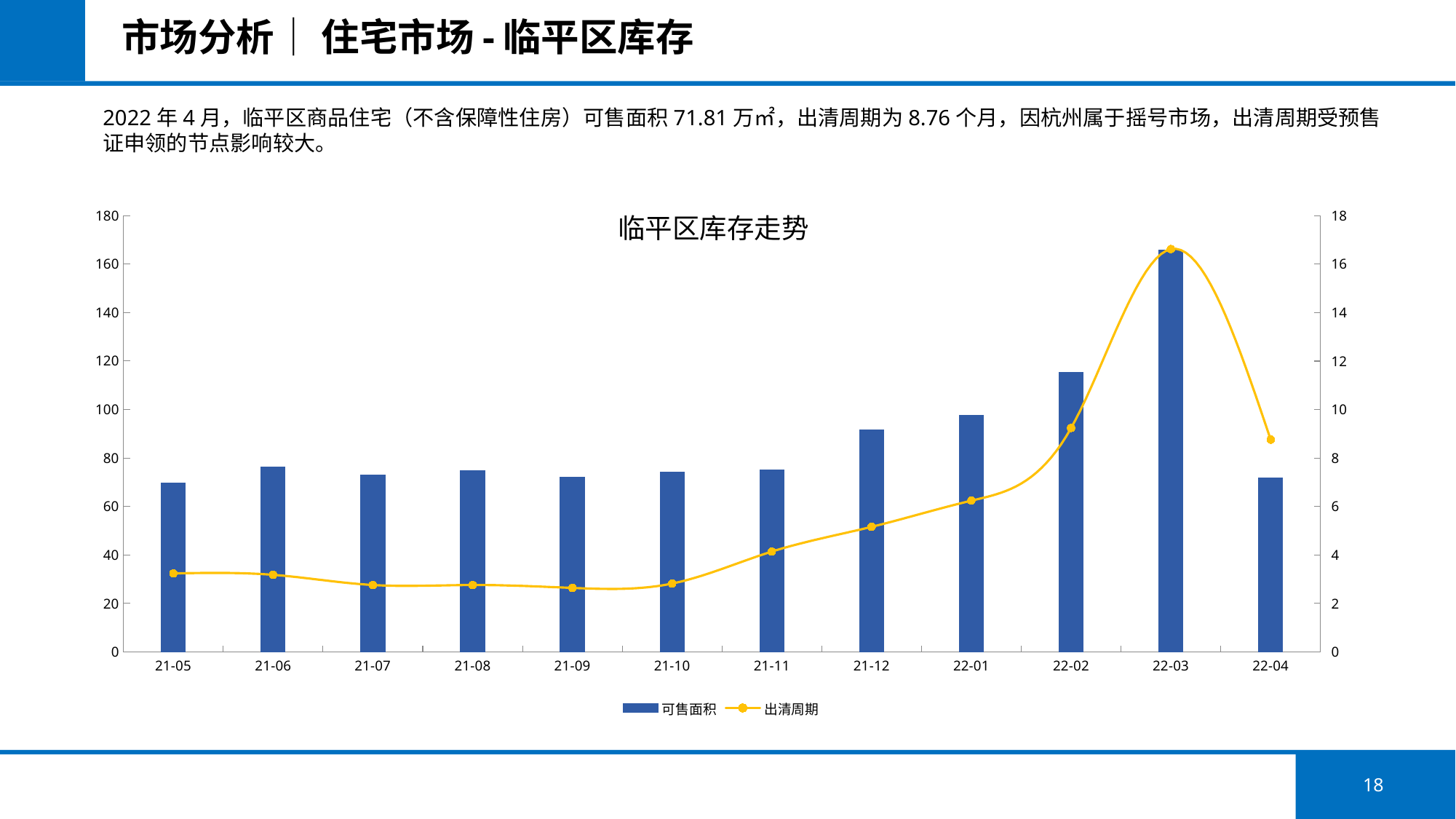
Which month has the highest 出清周期 value? 22-03 How many months are shown on the x axis? 12 Does the 出清周期 line rise or fall from 21-10 to 22-03? rise What is the title of the chart? 临平区库存走势 Is the 可售面积 value for 21-05 greater or less than 80? less Is the 可售面积 value for 22-02 greater or less than 100? greater How many series does the legend list? 2 Which has the larger 可售面积 bar, 21-12 or 22-02? 22-02 Is the 出清周期 value for 22-04 greater or less than 10? less What kind of chart is shown on the slide? A combined bar and line chart Which month has the highest 可售面积 bar? 22-03